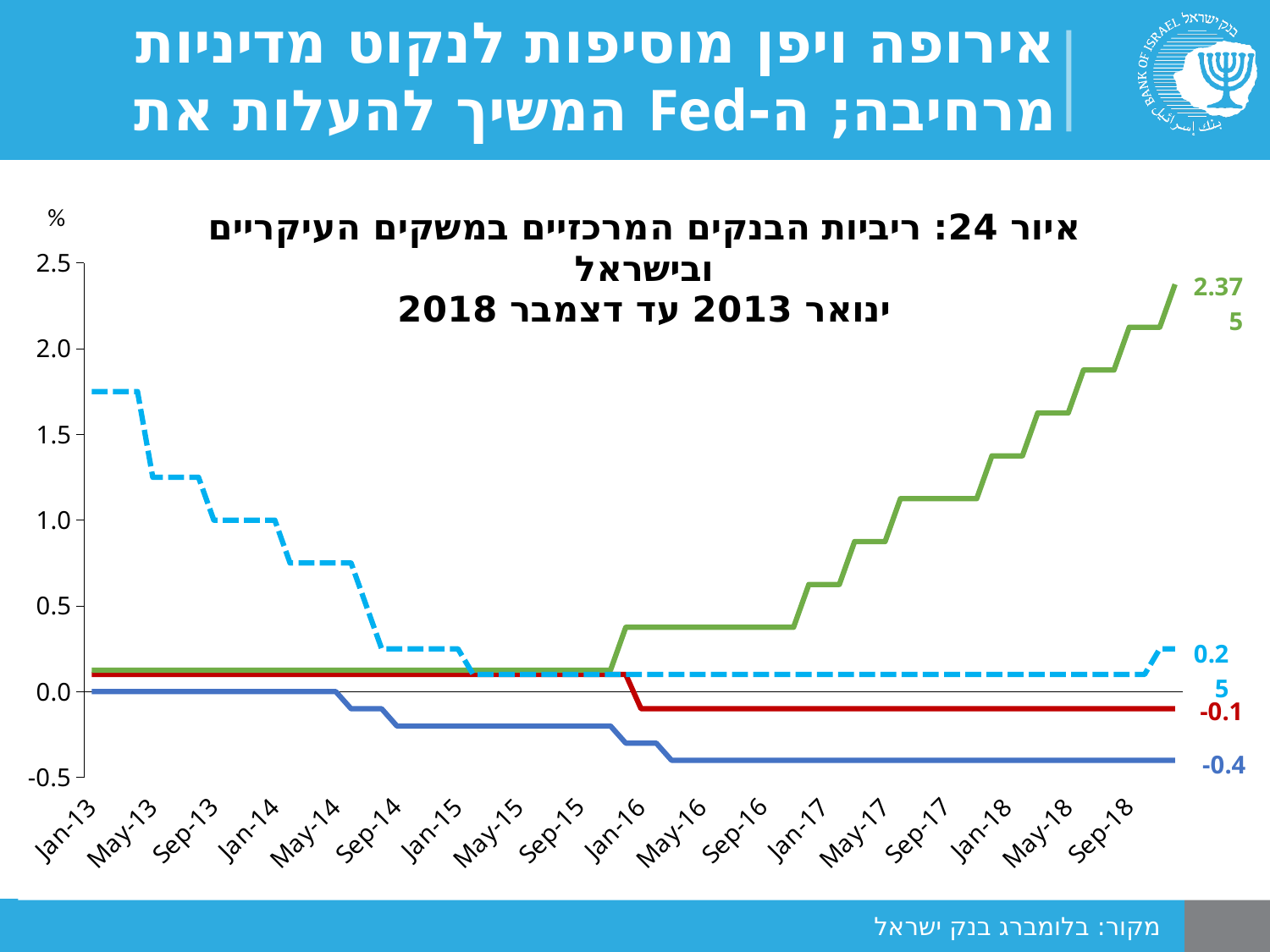
What unit is shown on the vertical axis of the chart? % Does the green line rise or fall between Jan-16 and Sep-18? rise What type of chart is shown on the slide? line chart Which line has the lowest value at the end of the period (Dec 2018)? the solid dark-blue line What is the final value labelled at the end of the dashed light-blue line? 0.25 What is the final value labelled at the end of the green line? 2.375 Which line has the highest value at the end of the period (Dec 2018)? the green line What is the final value labelled at the end of the solid dark-blue line? -0.4 What is the final value labelled at the end of the red line? -0.1 Is the value of the dashed light-blue line at Jan-13 greater or less than 1.5? greater How many lines are plotted on the chart? 4 What is the difference between the final labelled values of the green line (2.375) and the solid dark-blue line (-0.4)? 2.775